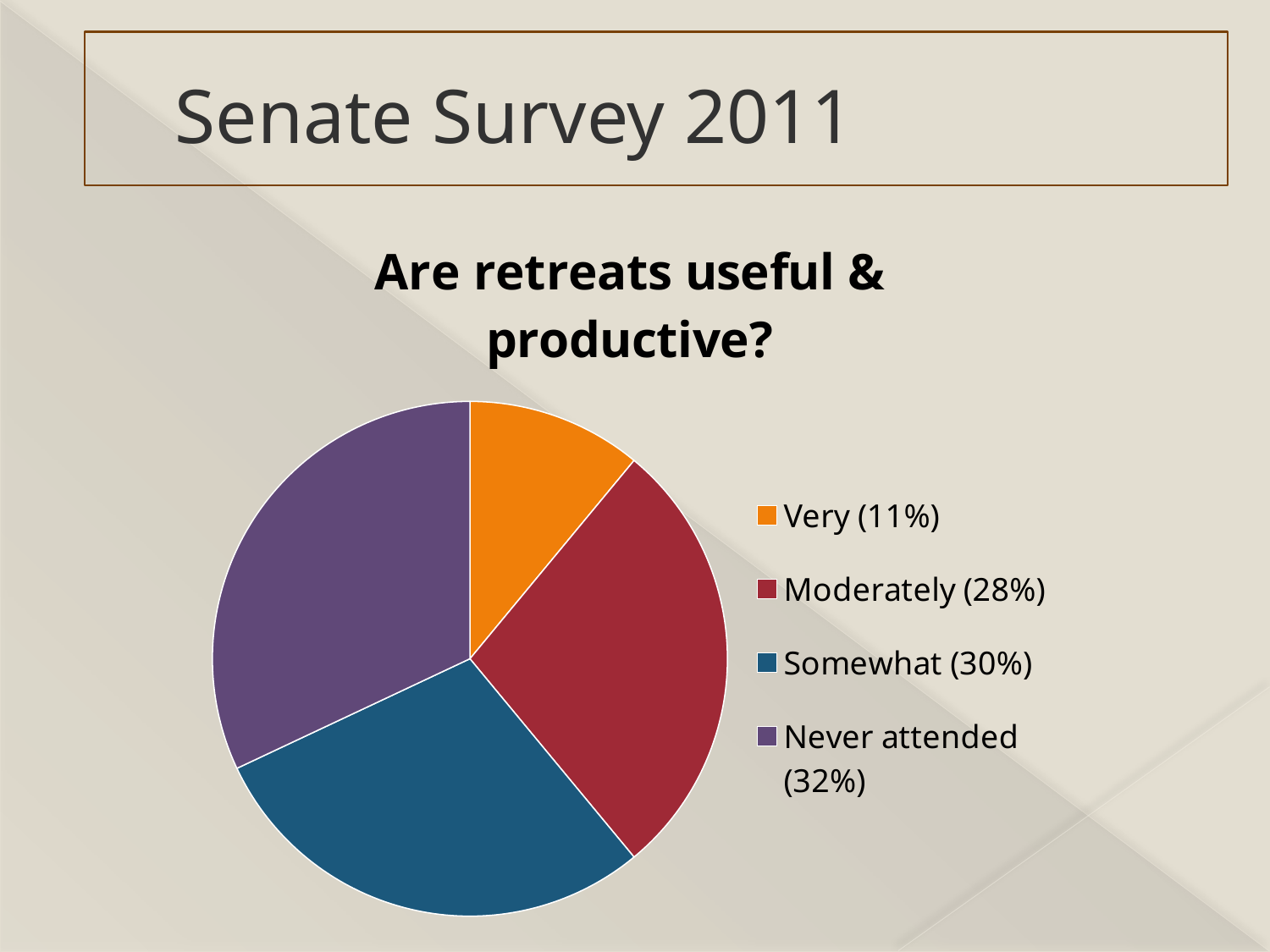
What share of respondents said retreats are Somewhat useful & productive? 30% Which category has the largest slice of the pie? Never attended What share of respondents said retreats are Very useful & productive? 11% What share of respondents had Never attended a retreat? 32% Which category has the smallest slice of the pie? Very Which is larger, the share for Moderately or the share for Very? Moderately How many categories does the pie chart show? 4 What kind of chart is shown on the slide? pie chart What is the title of the chart? Are retreats useful & productive? What colour is the slice for Somewhat? blue What is the difference in percentage points between Never attended and Very? 21